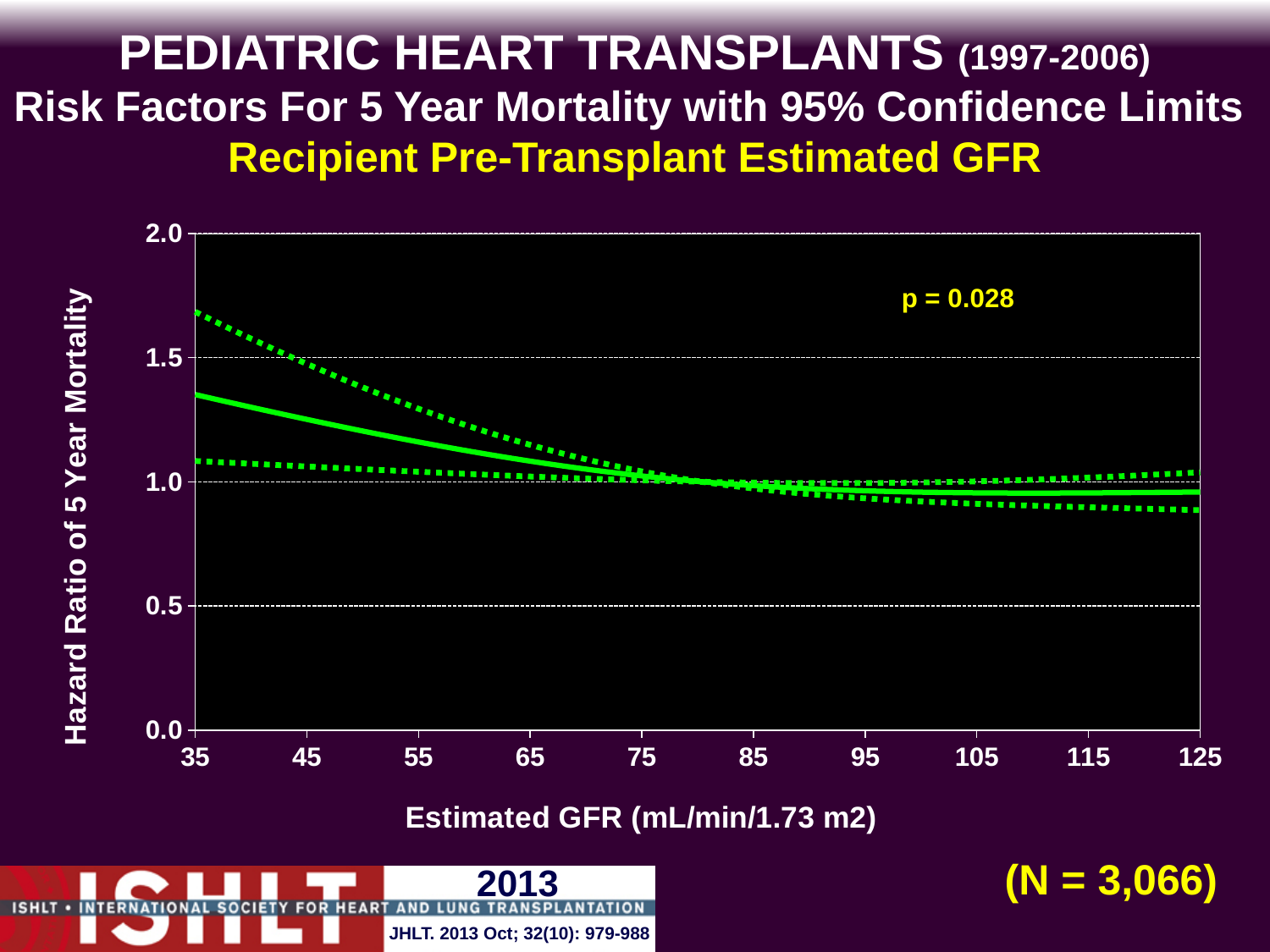
What kind of chart is shown on the slide? line chart Is the lower dotted confidence limit at an Estimated GFR of 35 greater or less than 1.0? greater Does the solid hazard ratio line rise or fall as Estimated GFR increases from 35 to 125? fall Is the hazard ratio on the solid line at an Estimated GFR of 125 greater or less than 1.0? less How many lines are plotted on the chart? 3 Is the upper dotted confidence limit at an Estimated GFR of 35 greater or less than 1.5? greater What p-value is shown on the chart? p = 0.028 What is the label of the x axis? Estimated GFR (mL/min/1.73 m2) Is the hazard ratio on the solid line higher at an Estimated GFR of 35 or at 125? 35